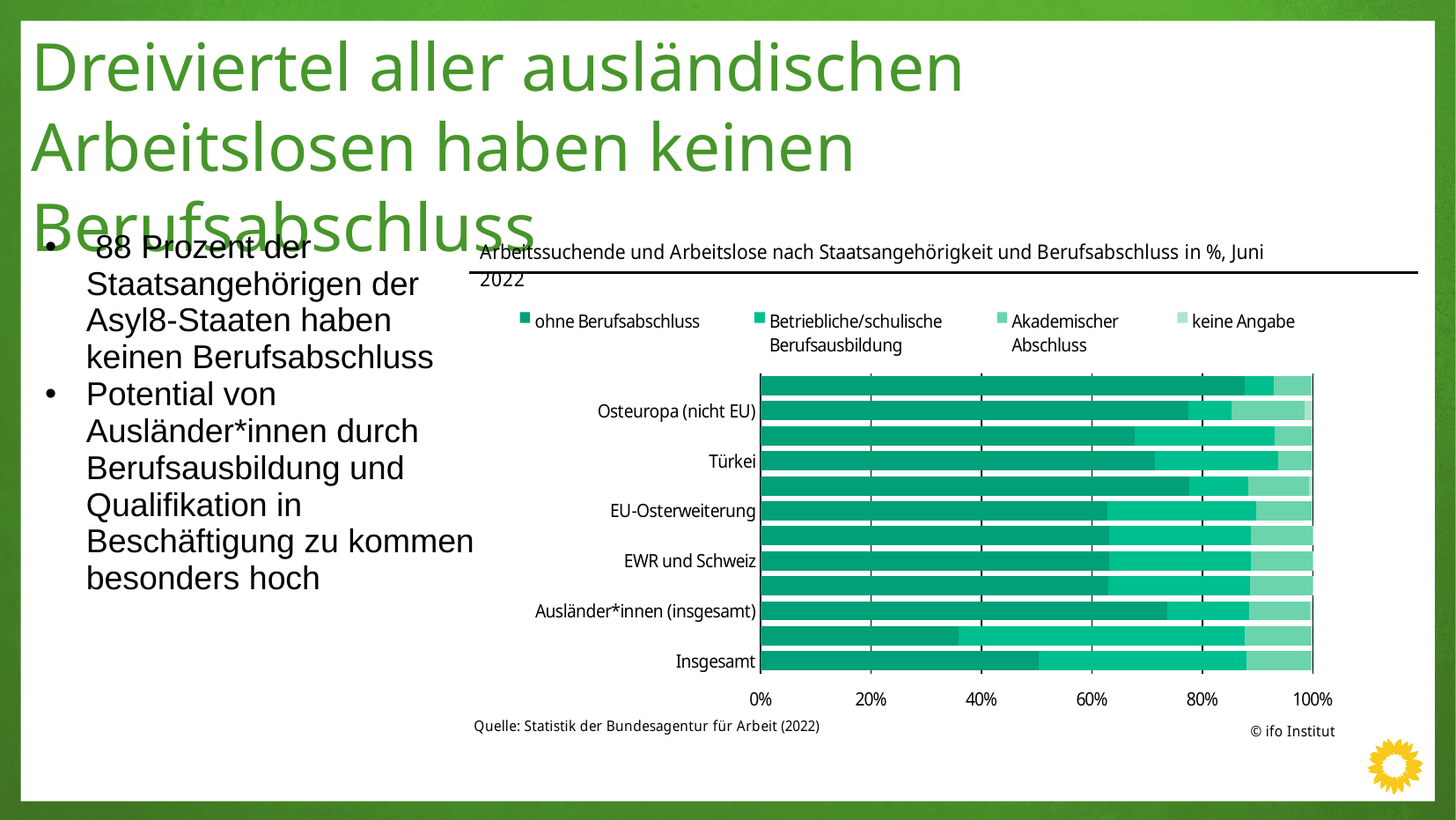
What is the first series listed in the chart's legend? ohne Berufsabschluss Is the 'ohne Berufsabschluss' share for Ausländer*innen (insgesamt) greater or less than 60%? greater Among the labelled categories, which has the smallest 'ohne Berufsabschluss' share? Insgesamt Is the 'ohne Berufsabschluss' share for Insgesamt greater or less than 60%? less Is the 'ohne Berufsabschluss' share for Insgesamt greater or less than 40%? greater What kind of chart is shown on the slide? Stacked bar chart What is the title of the chart? Arbeitssuchende und Arbeitslose nach Staatsangehörigkeit und Berufsabschluss in %, Juni 2022 How many series does the chart's legend list? 4 Which has the larger 'ohne Berufsabschluss' share, Türkei or Insgesamt? Türkei